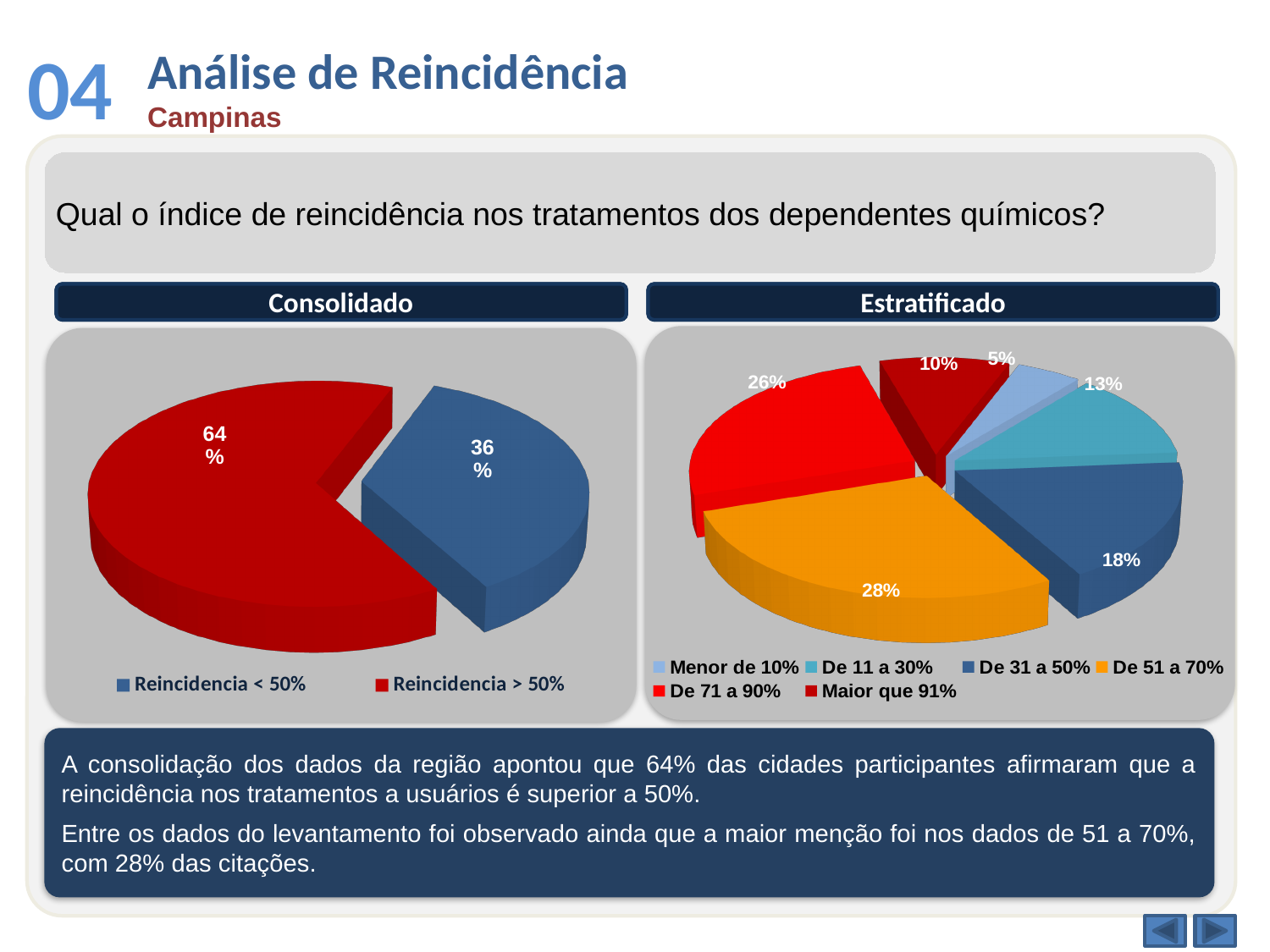
In the Estratificado chart, what share is labelled for De 51 a 70%? 28% In the Consolidado chart, what is the difference in percentage points between Reincidencia > 50% and Reincidencia < 50%? 28 In the Estratificado chart, which is larger: De 11 a 30% or Maior que 91%? De 11 a 30% In the Consolidado chart, what share is labelled for Reincidencia < 50%? 36% In the Estratificado chart, which category has the smallest slice? Menor de 10% In the Estratificado chart, what share is labelled for De 71 a 90%? 26% In the Estratificado chart, what is the difference in percentage points between De 31 a 50% and Menor de 10%? 13 In the Consolidado chart, what share is labelled for Reincidencia > 50%? 64% In the Consolidado chart, which category has the larger slice? Reincidencia > 50% What kind of chart is the Consolidado chart? Pie chart How many categories does the legend of the Estratificado chart list? 6 In the Estratificado chart, what share is labelled for De 31 a 50%? 18%